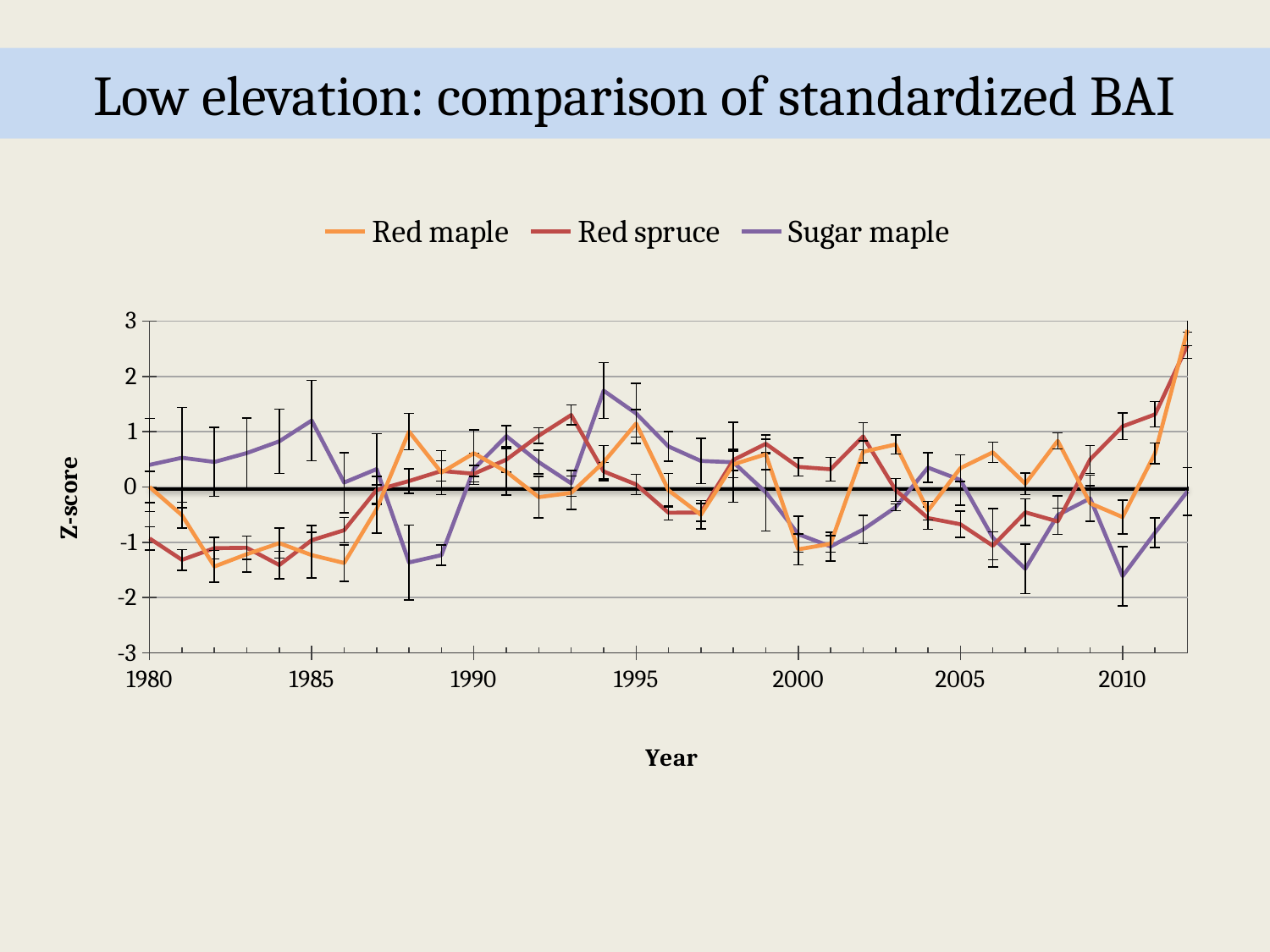
What kind of chart is shown on the slide? Line chart Which series are listed in the legend? Red maple, Red spruce, Sugar maple Is the value for Sugar maple in 1994 greater or less than 1? greater How many series does the legend list? 3 Is the value for Sugar maple in 2010 greater or less than -1? less Is the value for Red spruce in 1981 greater or less than -1? less What is the label of the vertical axis? Z-score Does the Red maple series rise or fall from 2010 to 2012? Rise In 1988, which series has the larger value, Red maple or Sugar maple? Red maple In which year does the Red maple series reach its highest value? 2012 In 1994, which series has the larger value, Sugar maple or Red spruce? Sugar maple